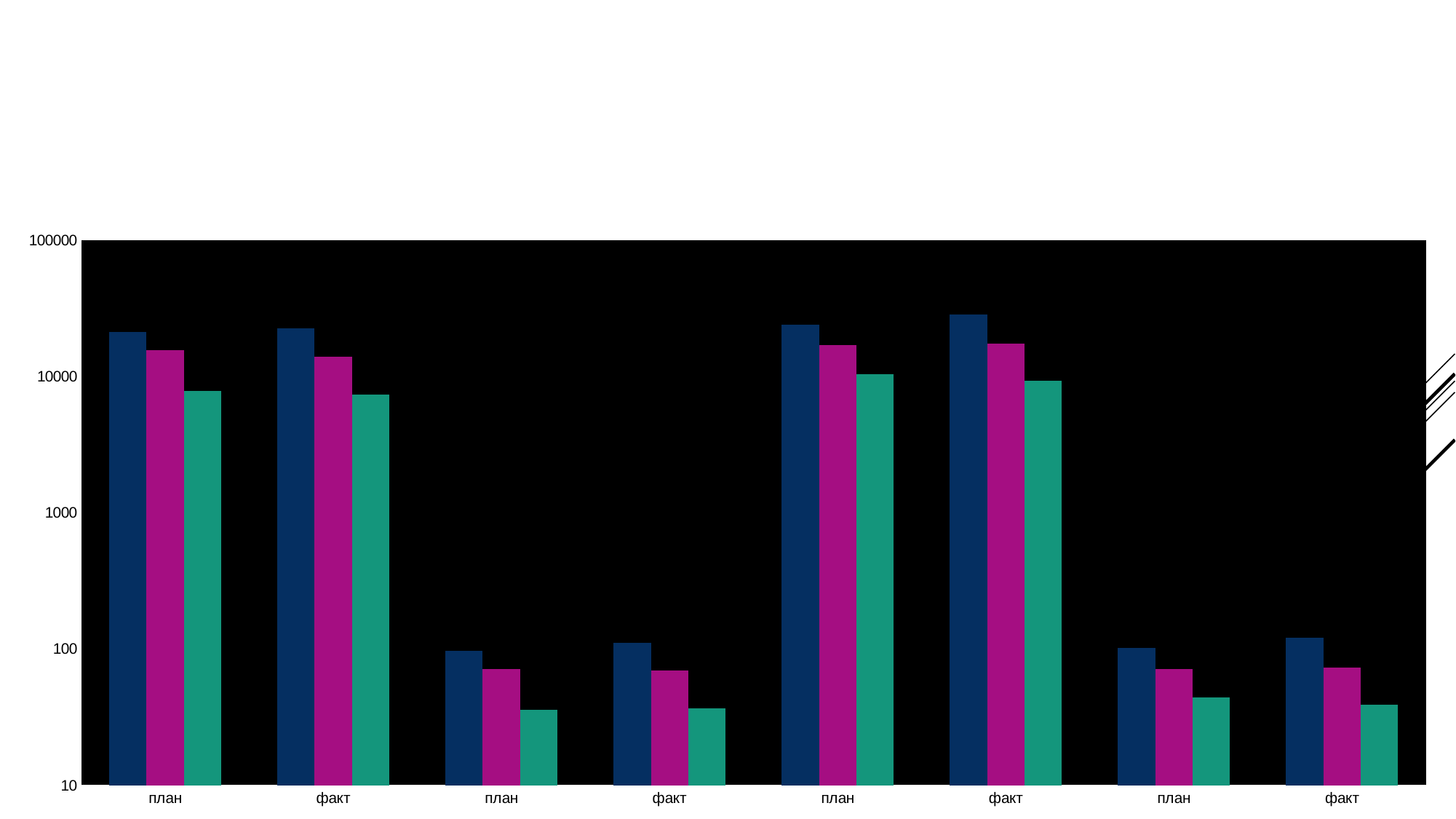
What kind of chart is shown on the slide? bar chart How many bars are there in each category group? 3 Is the value of the teal bar in the eighth group from the left (факт) greater or less than 100? less Is the value of the dark blue bar in the sixth group from the left (факт) greater or less than 10000? greater Is the value of the dark blue bar in the first group from the left (план) greater or less than 10000? greater In the first group from the left (план), which is larger: the dark blue bar or the teal bar? the dark blue bar Within each category group, which colour of bar is consistently the lowest? teal Which category group from the left has the tallest dark blue bar? the sixth group (факт) What is the highest value labelled on the y axis? 100000 How many category groups are shown along the x axis? 8